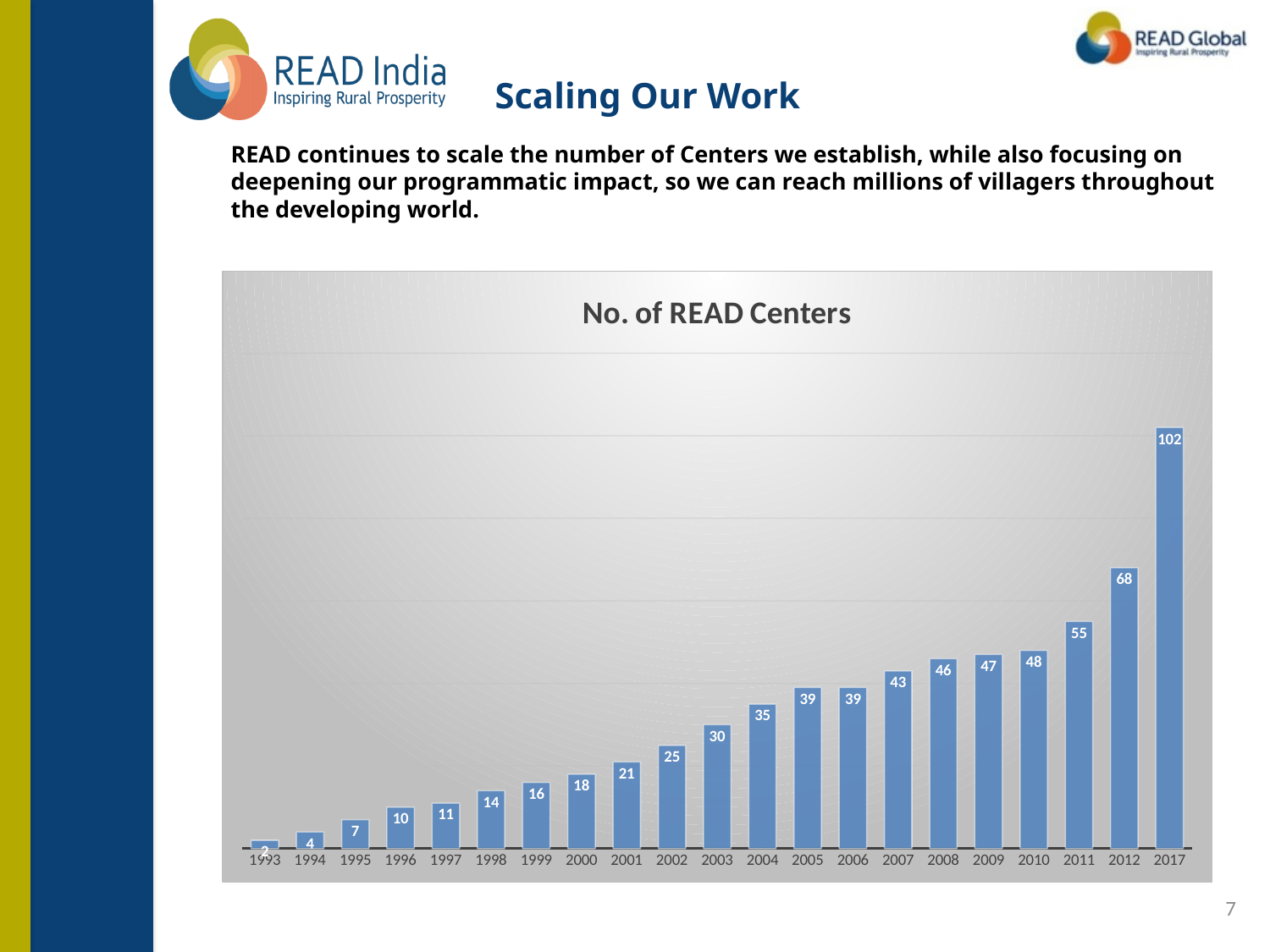
Which year had more READ Centers, 2003 or 2008? 2008 What is the difference in the number of READ Centers between 2017 and 2012? 34 What kind of chart is shown on the slide? bar chart How many years are shown on the x axis of the chart? 21 Do the number of READ Centers generally rise or fall from 1993 to 2017? rise What is the number of READ Centers shown for 2000? 18 What is the difference in the number of READ Centers between 2011 and 2010? 7 What is the number of READ Centers shown for 2005? 39 How many READ Centers were there in 2017? 102 Which year has the highest number of READ Centers? 2017 Which year has the lowest number of READ Centers? 1993 What is the title of the chart? No. of READ Centers